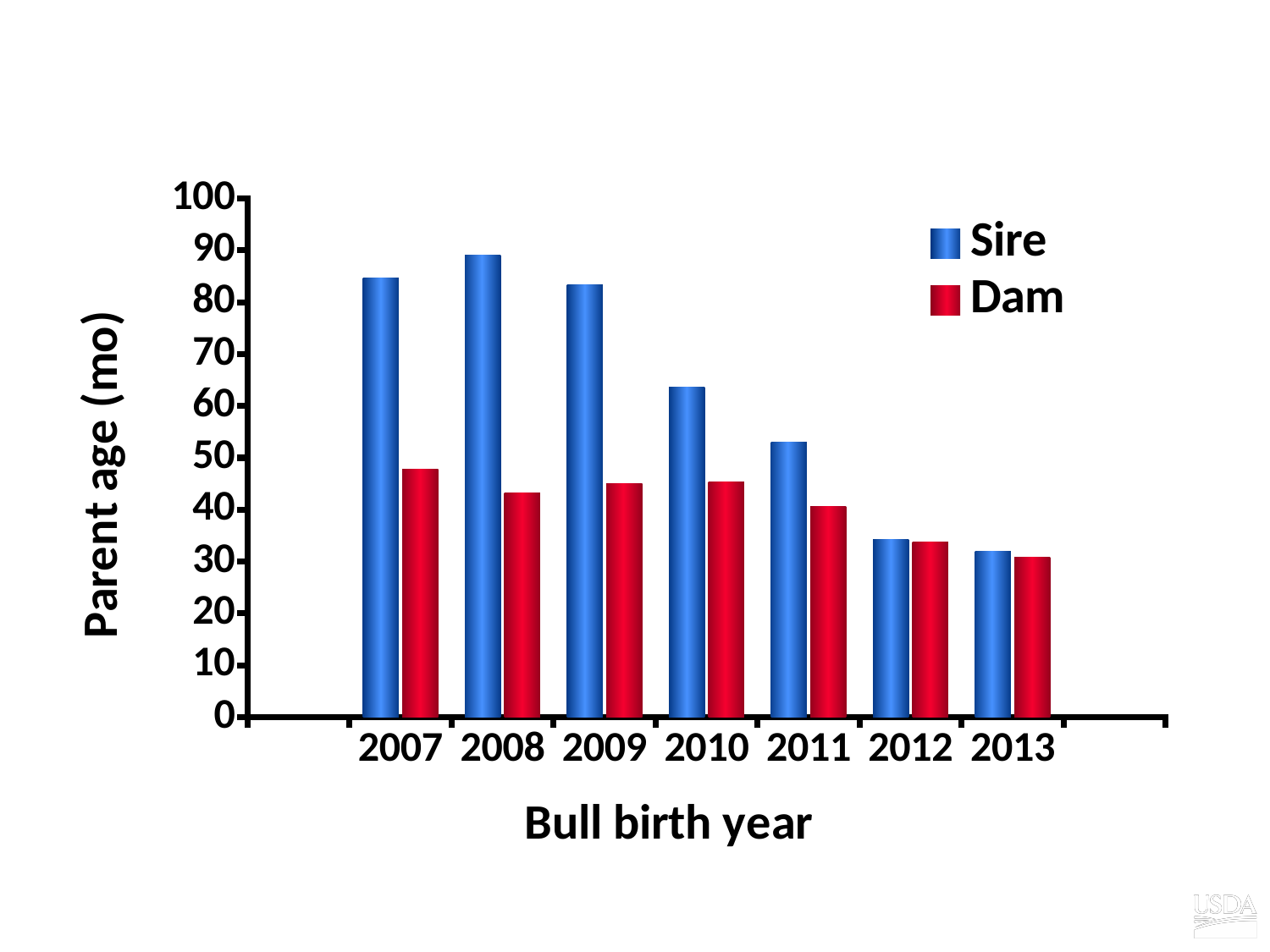
Is the Sire value for 2012 greater or less than 40? less Do the Sire values rise or fall from 2007 to 2013? fall Is the Sire value for 2010 greater or less than 60? greater For bull birth year 2007, which is larger, the Sire or the Dam parent age? Sire Is the Dam value for 2007 greater or less than 50? less What is the label of the y axis? Parent age (mo) What kind of chart is shown on the slide? bar chart How many series does the legend list? 2 How many bull birth years are shown on the x axis? 7 Which bull birth year has the lowest Dam parent age? 2013 Which bull birth year has the highest Sire parent age? 2008